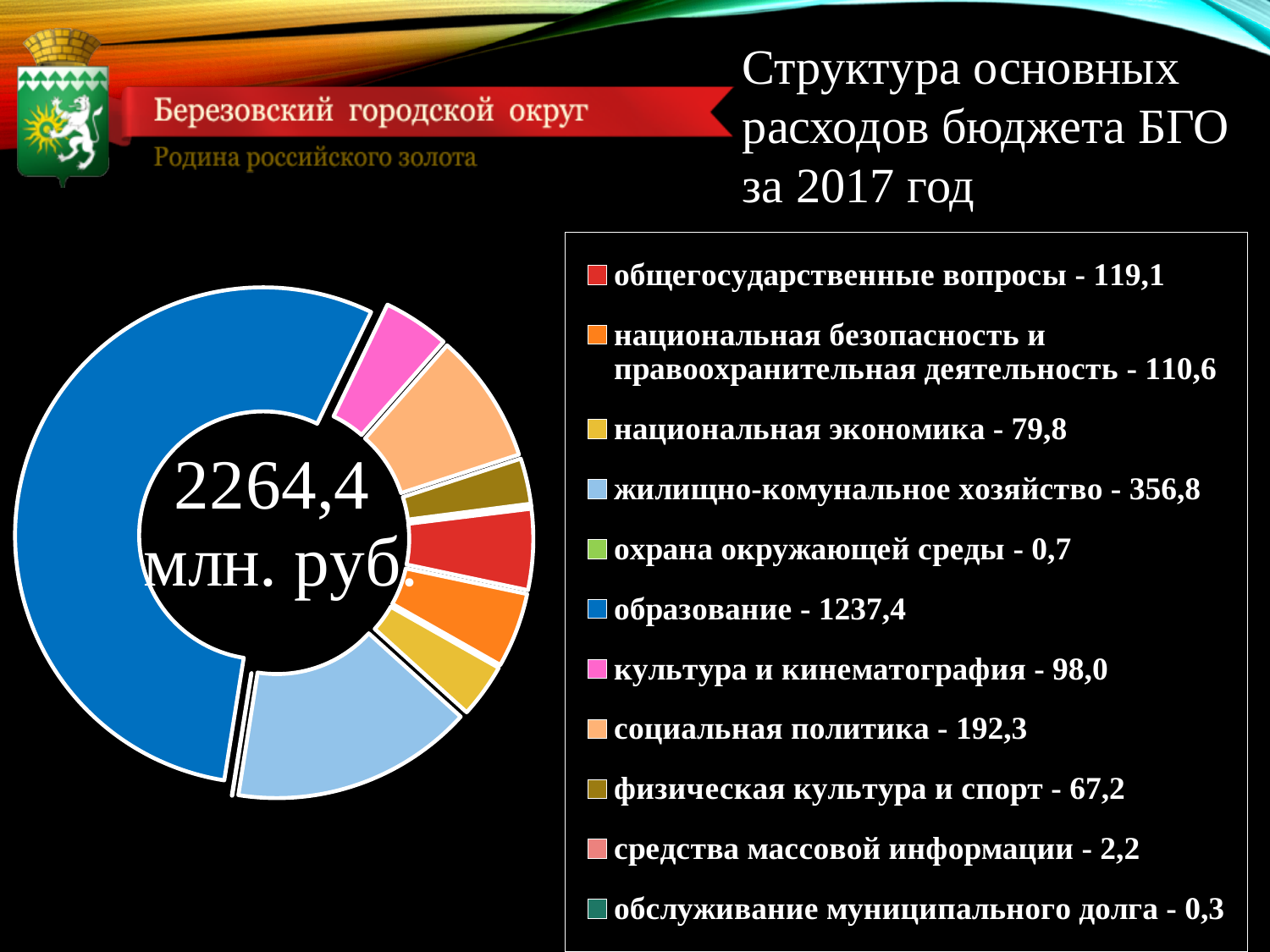
What total is shown in the centre of the chart? 2264,4 млн. руб. What is the value for жилищно-комунальное хозяйство? 356,8 What is the value for обслуживание муниципального долга? 0,3 What is the difference between жилищно-комунальное хозяйство and социальная политика? 164,5 What is the title of the chart? Структура основных расходов бюджета БГО за 2017 год What is the value for социальная политика? 192,3 Which category has the highest value? образование Which category has the lowest value? обслуживание муниципального долга How many categories does the legend list? 11 What kind of chart is shown on the slide? Doughnut (pie) chart What is the value for образование? 1237,4 Which is larger: общегосударственные вопросы or национальная безопасность и правоохранительная деятельность? общегосударственные вопросы